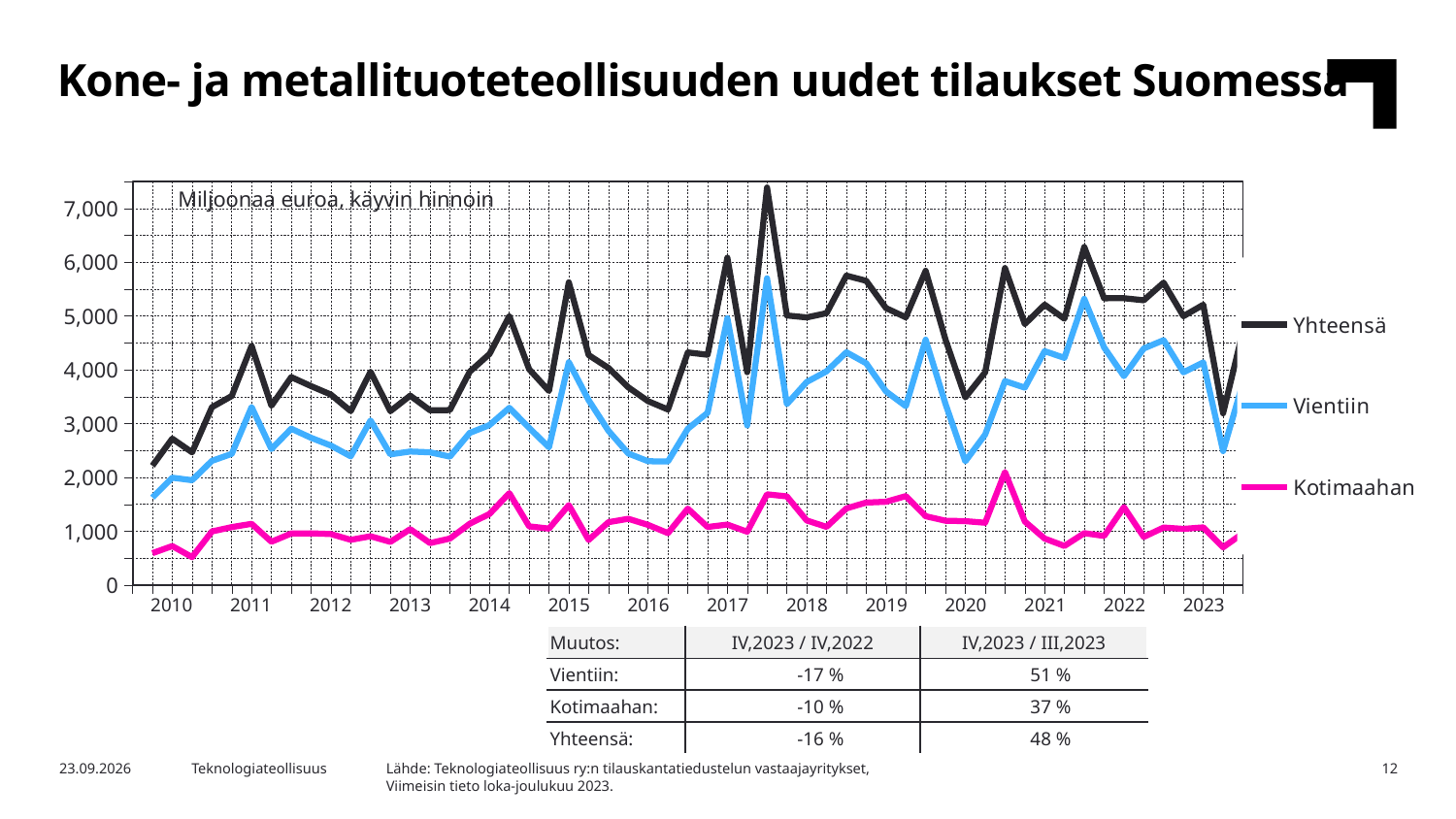
What are the three series named in the chart legend? Yhteensä, Vientiin, Kotimaahan How many year labels are shown on the x axis? 14 Which series has the highest values throughout the chart? Yhteensä What unit is stated in the chart's axis label text? Miljoonaa euroa, käyvin hinnoin Which series has the lowest values throughout the chart? Kotimaahan Which series is larger in 2021, Vientiin or Kotimaahan? Vientiin Is the peak value of the Yhteensä series in 2017 greater or less than 7,000? greater Does the Yhteensä series generally rise or fall from 2010 to 2017? rise How many series does the chart legend list? 3 What type of chart is shown on the slide? line chart Is the Kotimaahan series ever greater than 3,000 at any point on the chart? no Is the Vientiin value at the start of 2010 greater or less than 2,000? less